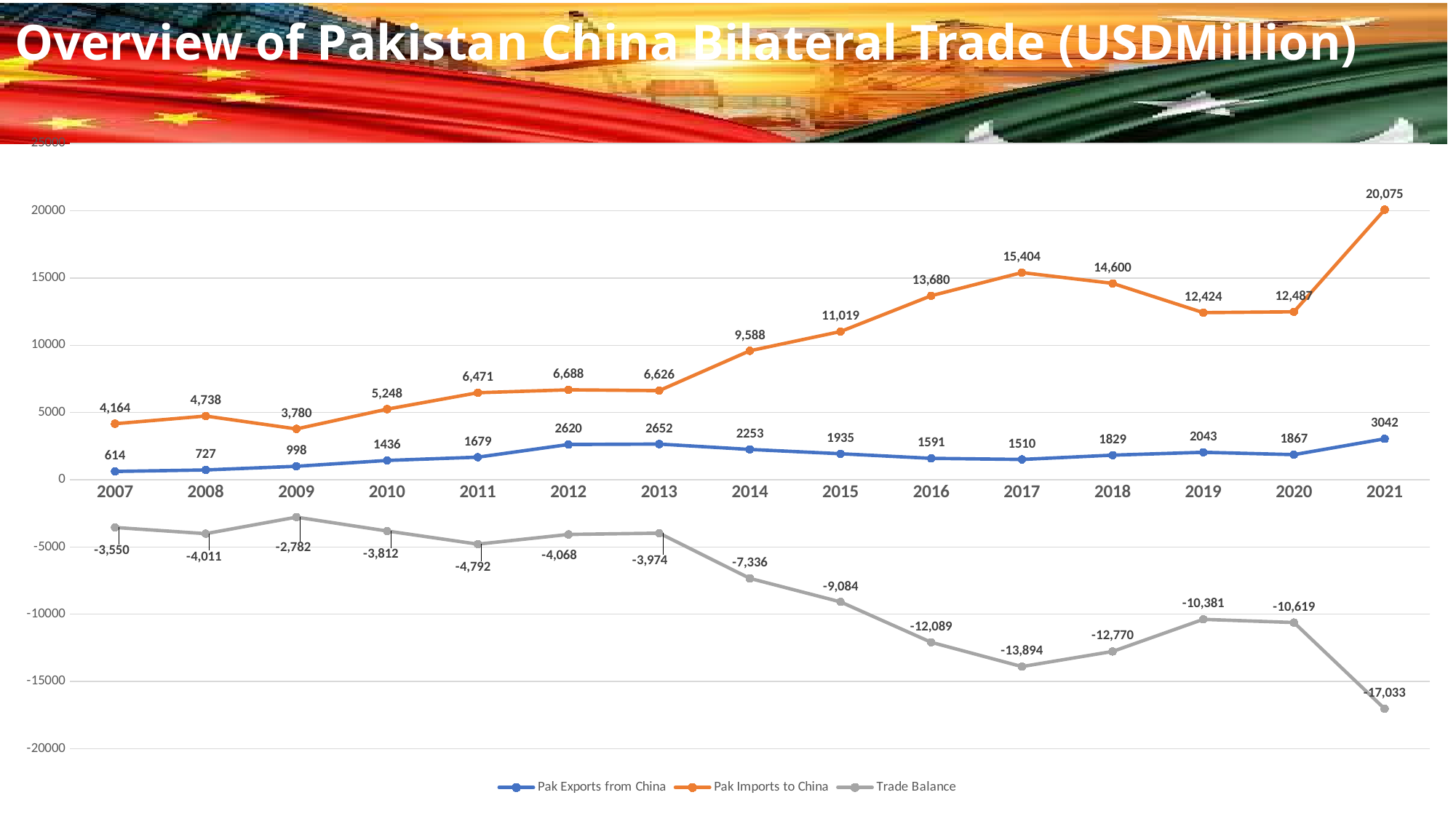
Which is larger, Pak Imports to China in 2019 or in 2020? 2020 What is the difference between Pak Imports to China in 2021 and in 2020? 7,588 In which year is Pak Exports from China at its lowest? 2007 What is the Trade Balance value in 2017? -13,894 Does the Trade Balance rise or fall from 2013 to 2017? Fall What is the value of Pak Exports from China in 2013? 2652 In which year is Pak Imports to China at its highest? 2021 How many years are plotted along the x axis? 15 What type of chart is shown on the slide? Line chart In which year is Pak Imports to China at its lowest? 2009 How many series does the legend list? 3 What is the value of Pak Imports to China in 2021? 20,075